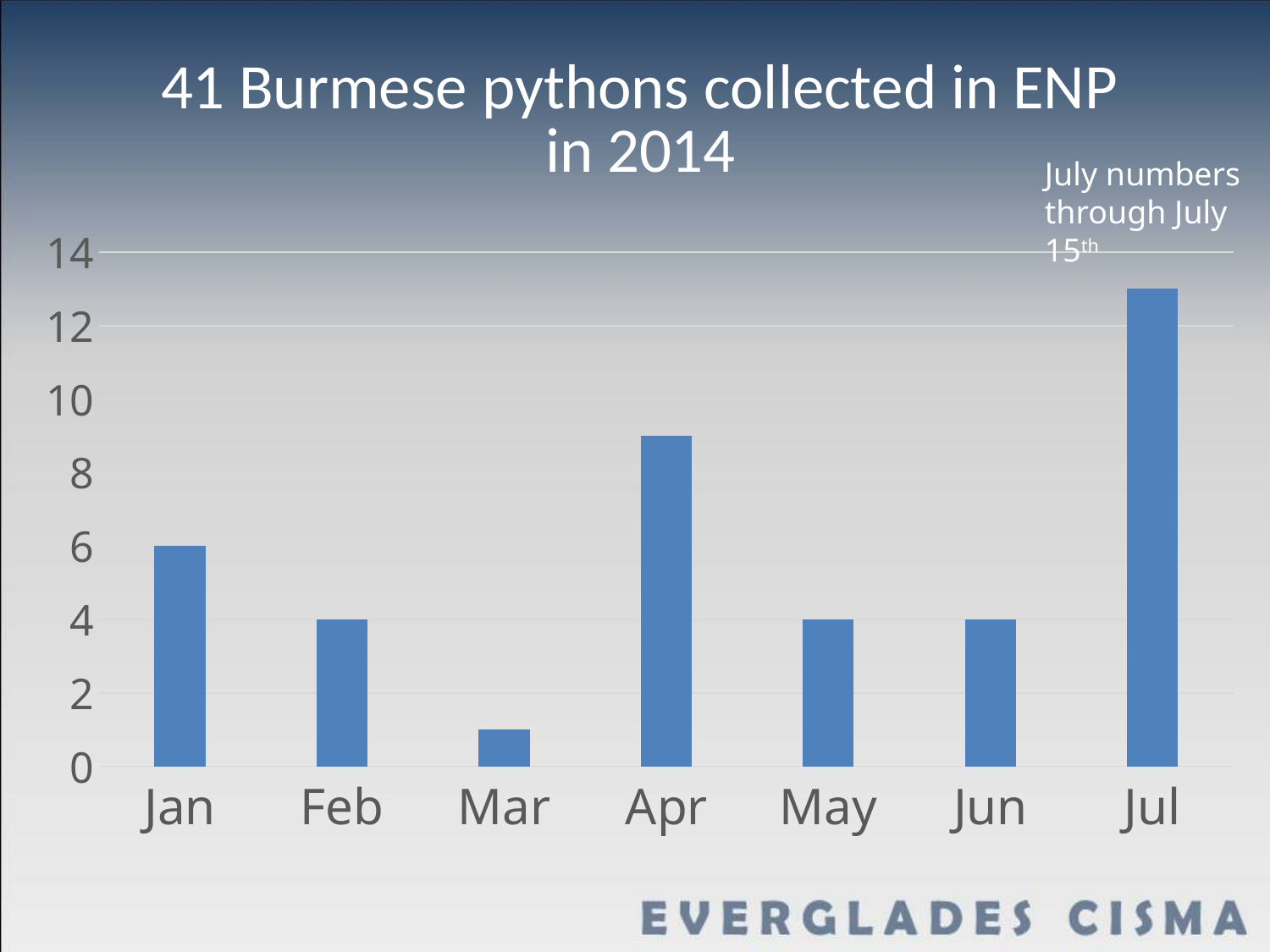
Which month has the lowest number of pythons collected? Mar Which month has the highest number of pythons collected? Jul How many pythons were collected in Feb? 4 What is the title of the chart? 41 Burmese pythons collected in ENP in 2014 Is the value for Apr greater or less than 8? greater What is the difference between the values for Jan and Feb? 2 How many pythons were collected in Jan? 6 How many months are shown on the x axis? 7 How many pythons were collected in Jun? 4 Is the value for Mar greater or less than 2? less What type of chart is shown on the slide? Bar chart Which month has a larger value, Apr or Jan? Apr